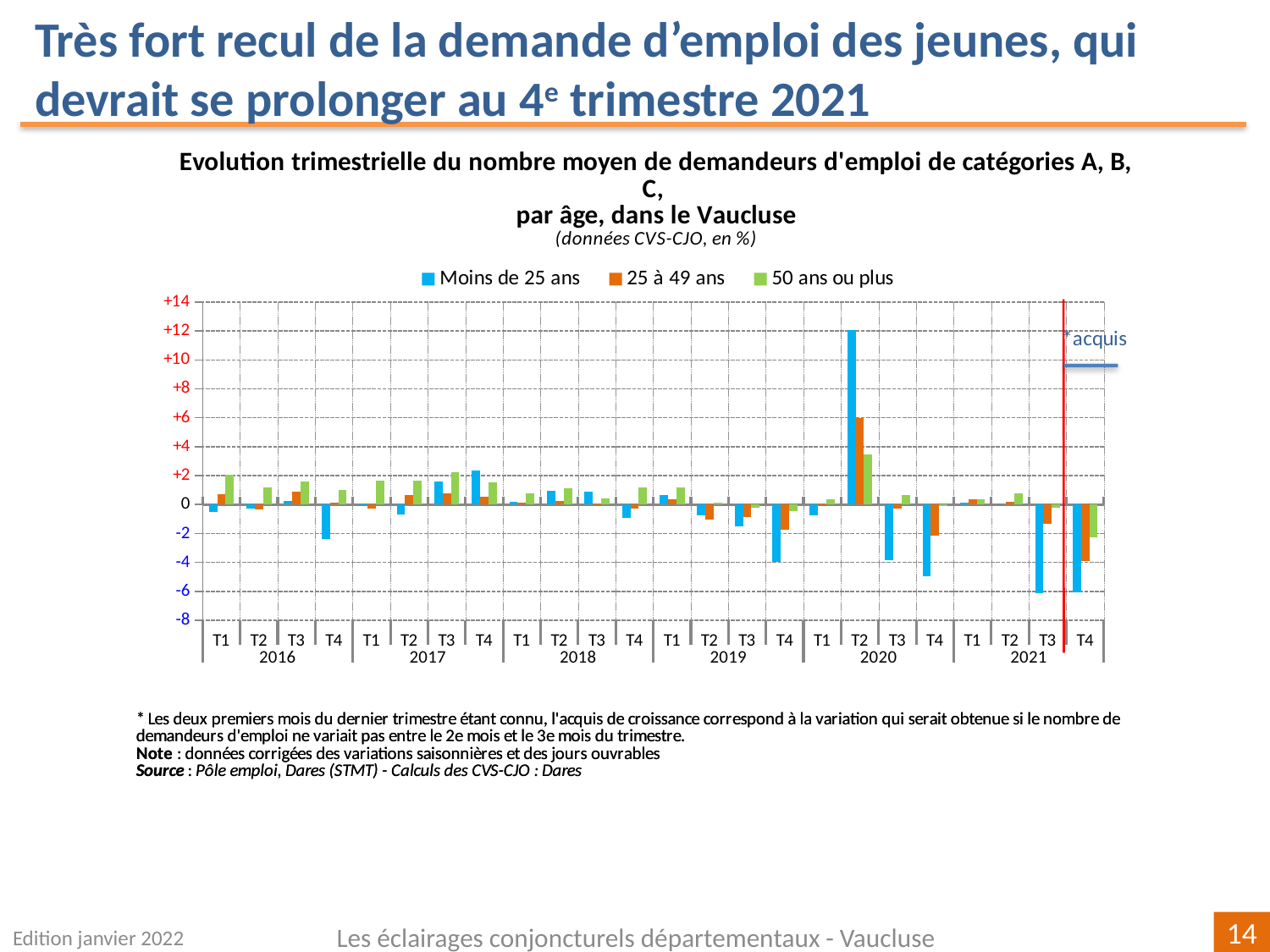
Is the value for Moins de 25 ans in T4 2019 greater or less than -2? less Is the value for Moins de 25 ans in T4 2020 greater or less than -4? less Is the value for 25 à 49 ans in T2 2020 greater or less than +4? greater Which series has the highest value in T2 2020? Moins de 25 ans How many series does the legend list? 3 Which year's quarters are plotted first on the x axis? 2016 Which series is shown in blue in the legend? Moins de 25 ans What kind of chart is shown on the slide? bar chart In T4 2016, which is larger: the value for Moins de 25 ans or for 50 ans ou plus? 50 ans ou plus How many quarters (categories) are plotted along the x axis? 24